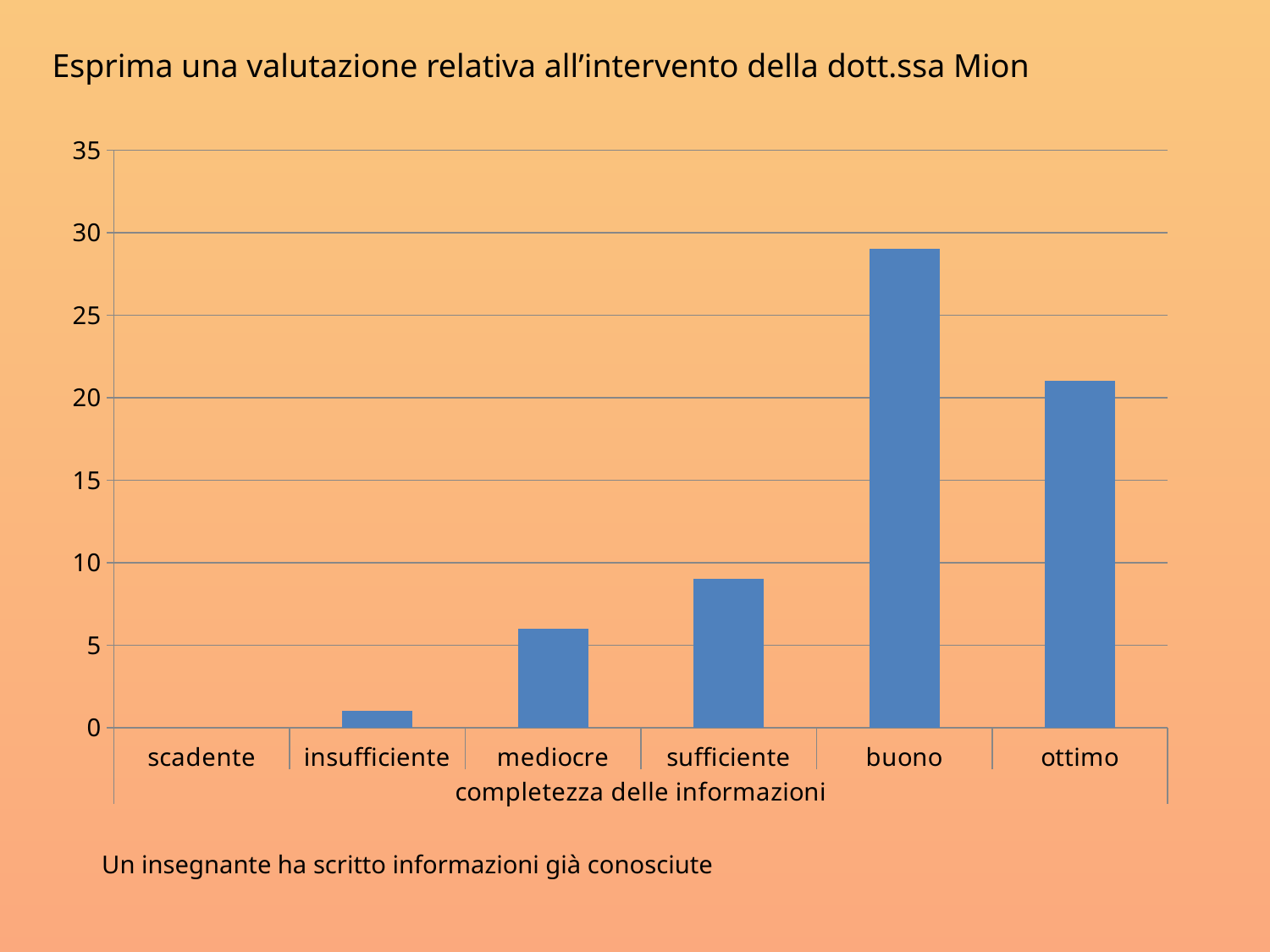
Is the value for ottimo greater or less than 25? less Is the value for buono greater or less than 25? greater Which is larger, the value for mediocre or the value for sufficiente? sufficiente What is the label shown under the x axis of the chart? completezza delle informazioni Which category has the lowest value in the chart? scadente How many categories are shown on the x axis of the chart? 6 Is the value for mediocre greater or less than 5? greater Which category has the highest value in the chart? buono Which is larger, the value for buono or the value for ottimo? buono What kind of chart is shown on the slide? bar chart